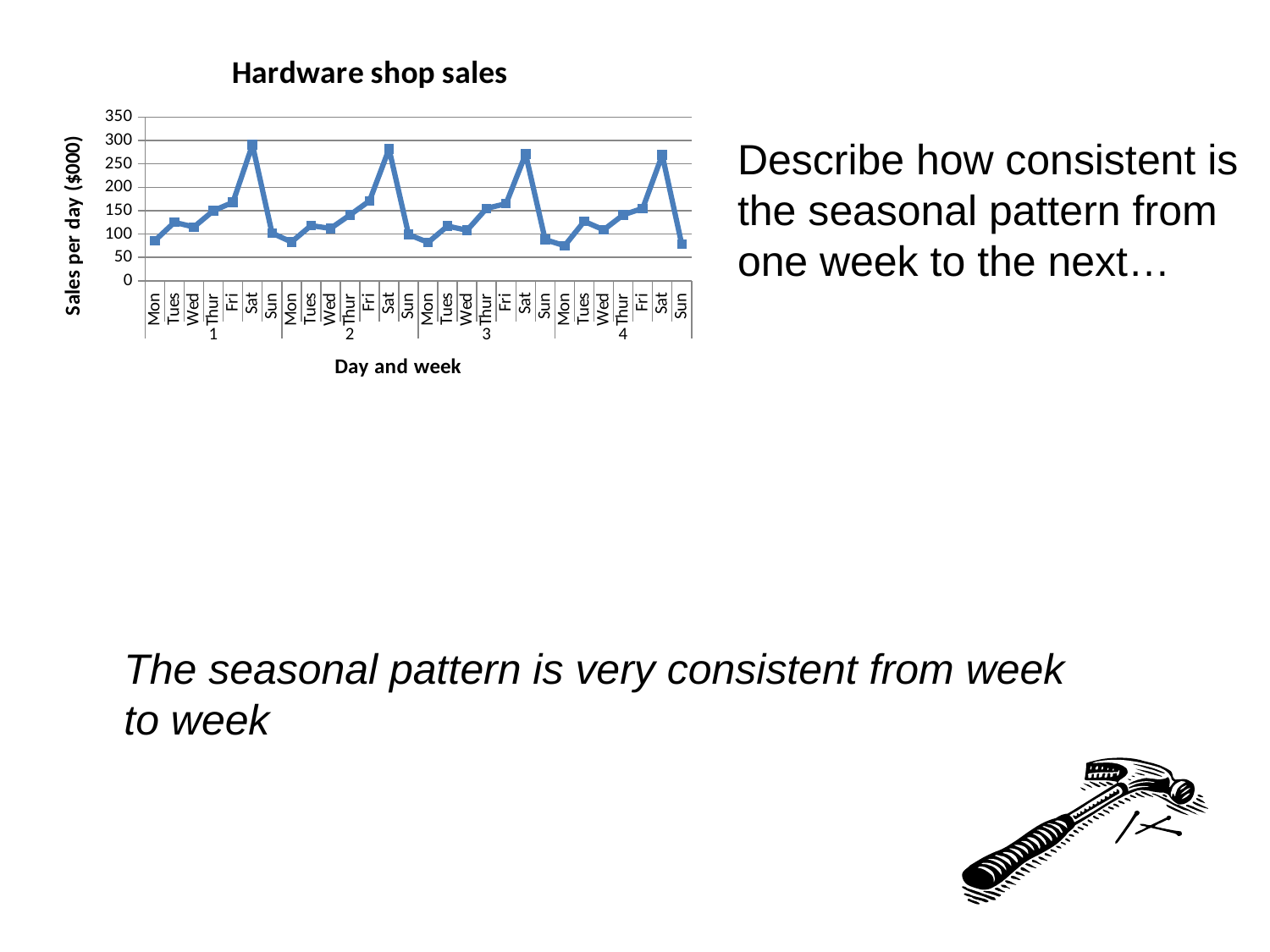
Is the value for Mon in week 1 greater or less than 100? less Within each week, do sales rise or fall from Mon to Sat? Rise What is the label on the vertical axis of the chart? Sales per day ($000) How many data points are plotted on the chart in total? 28 Which is larger, the value for Fri in week 2 or the value for Wed in week 2? Fri in week 2 What kind of chart is shown on the slide? Line chart Is the value for Fri in week 3 greater or less than 150? greater Is the value for Sat in week 1 greater or less than 250? greater How many weeks of data are plotted on the chart? 4 Which day of the week has the highest sales in each week? Sat What is the title of the chart? Hardware shop sales